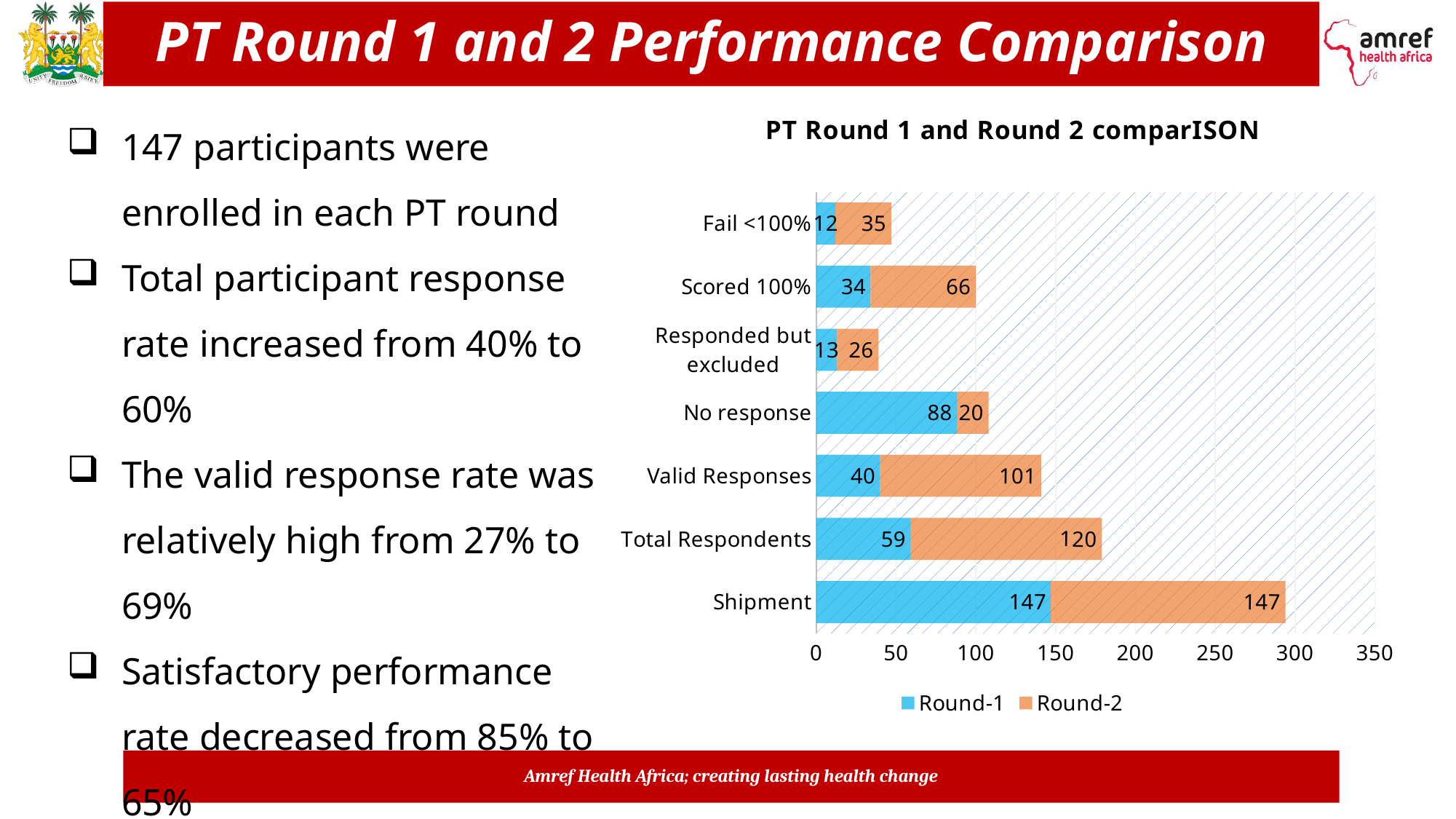
What is the Round-1 value for Valid Responses? 40 What is the difference between the Round-2 and Round-1 values for Scored 100%? 32 How many categories are shown on the chart? 7 What is the title of the chart? PT Round 1 and Round 2 comparISON What is the Round-2 value for Total Respondents? 120 Which is larger for No response: Round-1 or Round-2? Round-1 What is the total of the stacked bar for Total Respondents? 179 Which category has the lowest Round-1 value? Fail <100% Which category has the highest Round-2 value? Shipment What is the Round-2 value for No response? 20 What kind of chart is shown? Stacked bar chart How many series does the legend list? 2